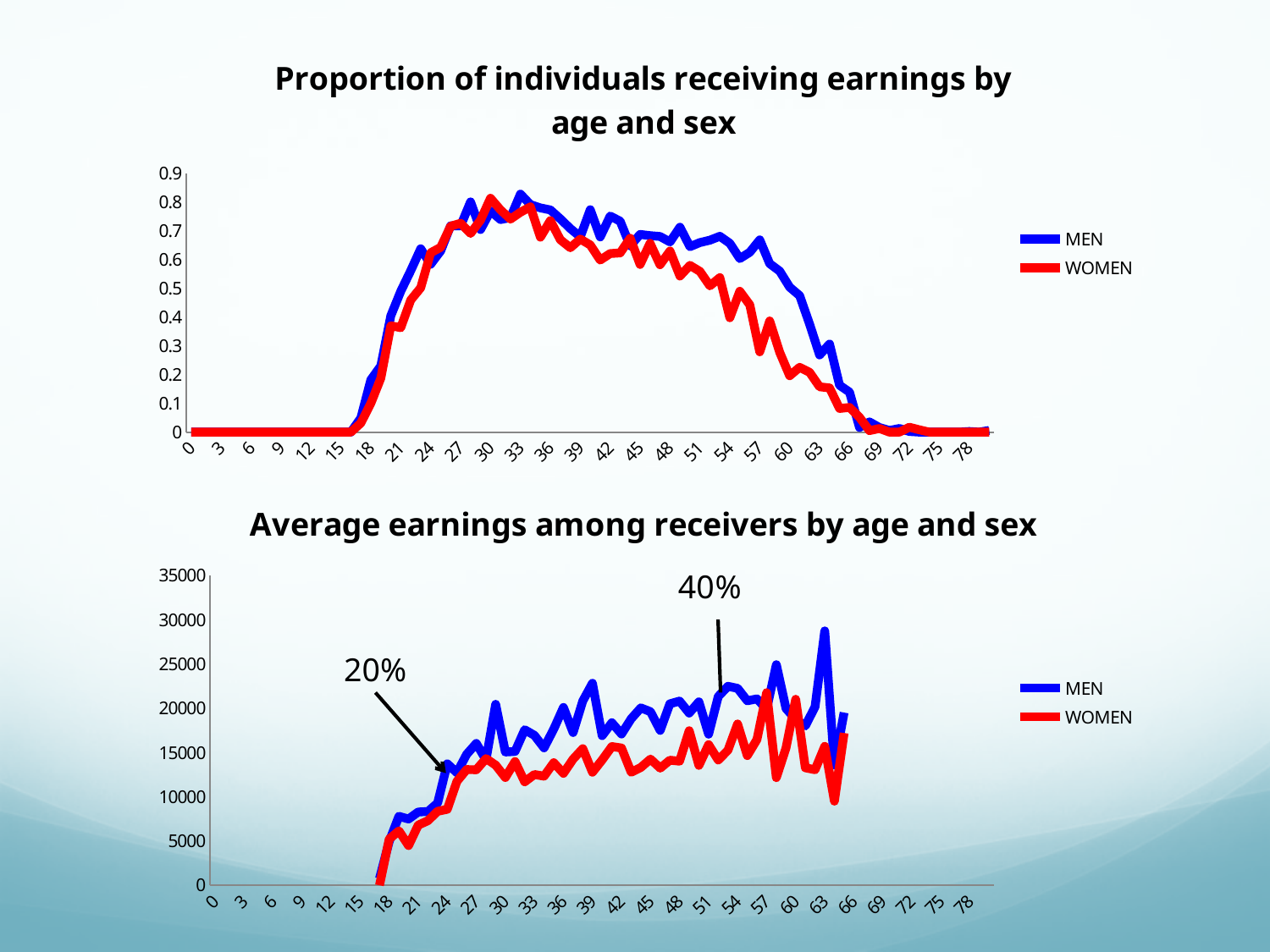
In the top chart, is the value for MEN at age 66 greater or less than 0.2? less What two percentage annotations are shown on the bottom chart? 20% and 40% In the top chart, do the values for MEN rise or fall between age 57 and age 66? fall In the top chart, is the value for MEN at age 30 greater or less than 0.7? greater In the bottom chart, is the value for WOMEN at age 21 greater or less than 10000? less In the top chart, which series has the higher value at age 57, MEN or WOMEN? MEN In the bottom chart, which series has the higher value at age 39, MEN or WOMEN? MEN What kind of chart is the top chart, 'Proportion of individuals receiving earnings by age and sex'? Line chart How many series does the legend of the top chart list? 2 In the bottom chart, do the values for WOMEN rise or fall between age 18 and age 27? rise